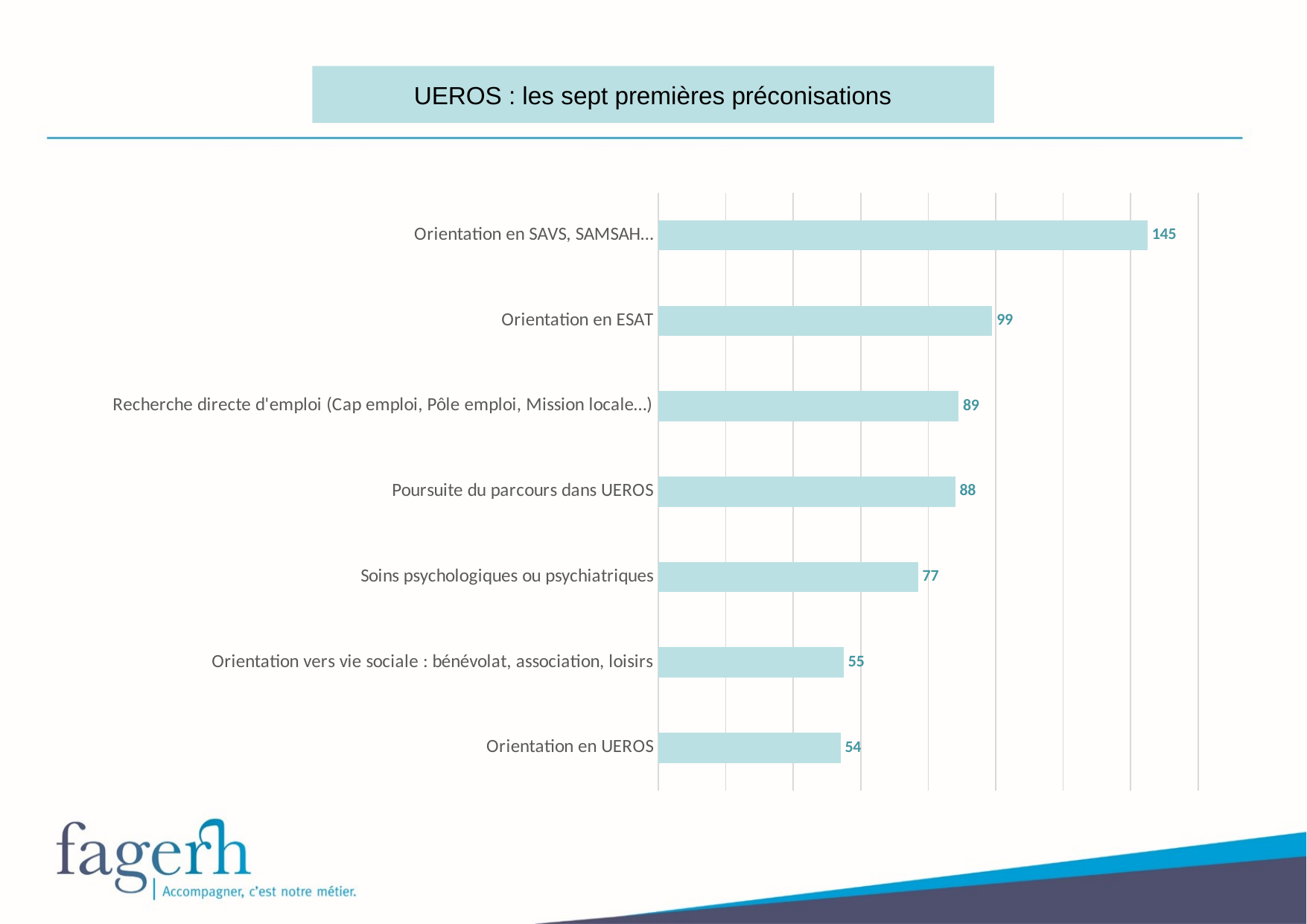
What is the value for Orientation en UEROS? 54 Which is larger: the value for Soins psychologiques ou psychiatriques or the value for Orientation vers vie sociale : bénévolat, association, loisirs? Soins psychologiques ou psychiatriques What is the value for Soins psychologiques ou psychiatriques? 77 Which category has the highest value? Orientation en SAVS, SAMSAH… What is the difference between the values for Orientation en SAVS, SAMSAH… and Orientation en ESAT? 46 How many categories are plotted in the chart? 7 What is the difference between the values for Recherche directe d'emploi (Cap emploi, Pôle emploi, Mission locale…) and Orientation vers vie sociale : bénévolat, association, loisirs? 34 What is the value for Poursuite du parcours dans UEROS? 88 What type of chart is shown on the slide? bar chart What is the value for Orientation en ESAT? 99 What is the title of the slide's chart? UEROS : les sept premières préconisations Which category has the lowest value? Orientation en UEROS